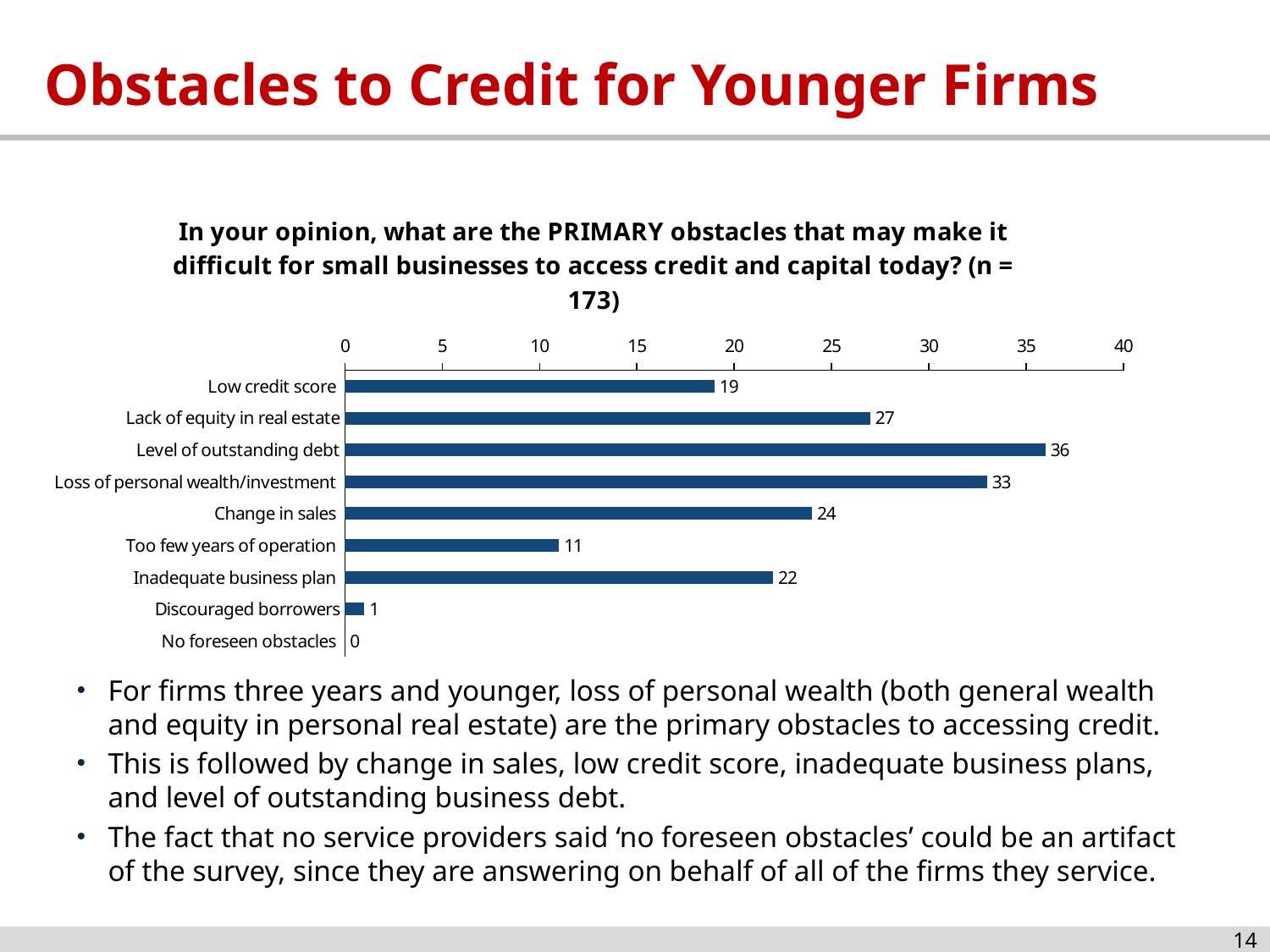
What is the value for Discouraged borrowers? 1 What kind of chart is shown on the slide? bar chart Which is larger, the value for Lack of equity in real estate or the value for Inadequate business plan? Lack of equity in real estate What sample size (n) is given in the chart title? 173 Which category has the highest value? Level of outstanding debt What is the difference between the values for Loss of personal wealth/investment and Change in sales? 9 What is the value for Too few years of operation? 11 Which category has the lowest value? No foreseen obstacles What is the maximum value shown on the horizontal axis? 40 What is the value for Level of outstanding debt? 36 Is the value for Low credit score greater or less than 20? less How many categories are shown in the chart? 9